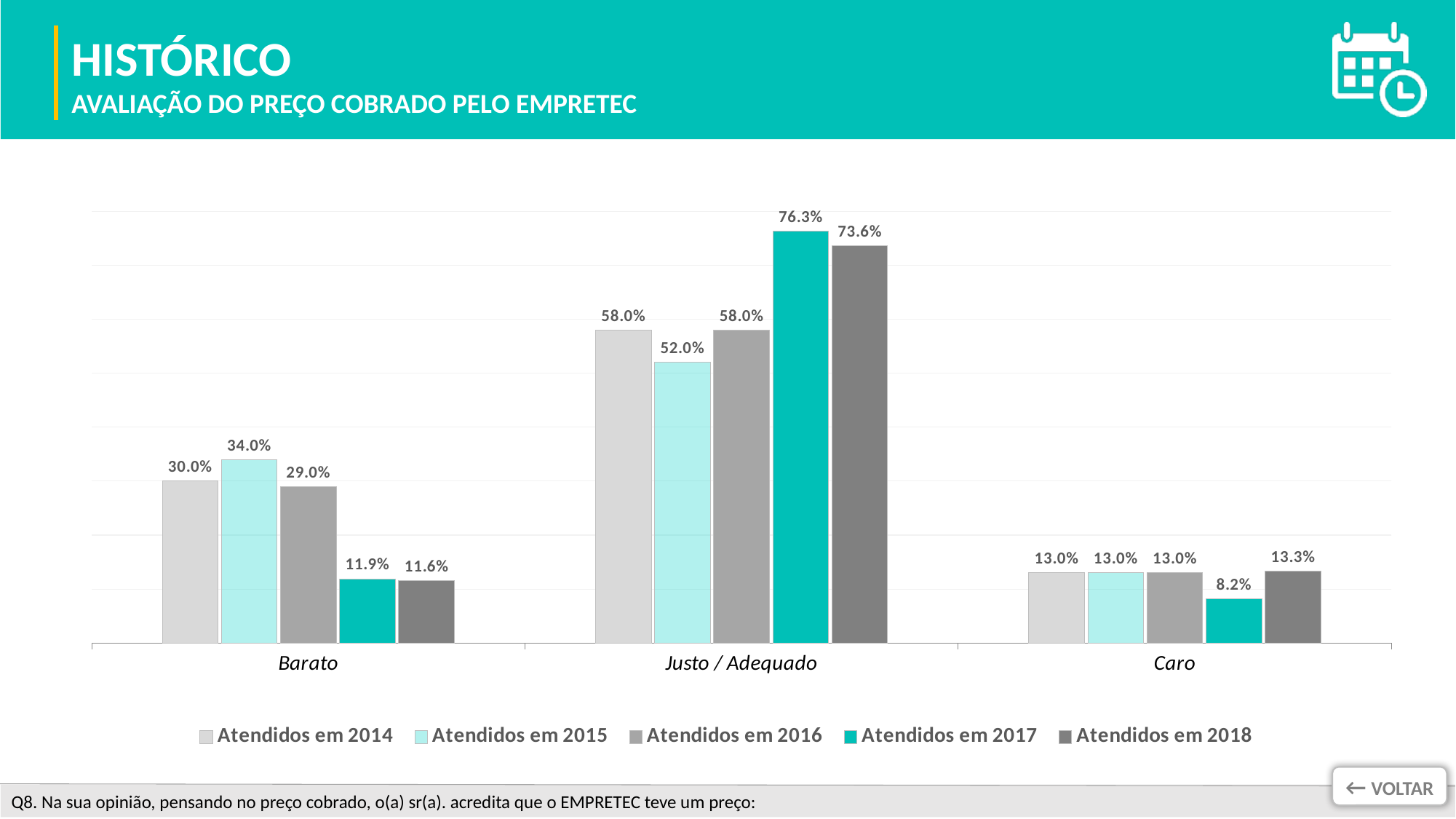
What is the subtitle of the chart shown on the slide? AVALIAÇÃO DO PREÇO COBRADO PELO EMPRETEC Which series has the highest value in the Justo / Adequado category? Atendidos em 2017 What kind of chart is shown on the slide? Bar chart What is the value for Atendidos em 2017 in the Justo / Adequado category? 76.3% What is the difference between the Atendidos em 2015 and Atendidos em 2018 values in the Barato category? 22.4% What is the value for Atendidos em 2015 in the Barato category? 34.0% Which series has the lowest value in the Caro category? Atendidos em 2017 Which is larger in the Barato category: Atendidos em 2014 or Atendidos em 2016? Atendidos em 2014 What is the difference between the Atendidos em 2017 and Atendidos em 2018 values in the Justo / Adequado category? 2.7% What is the value for Atendidos em 2018 in the Caro category? 13.3% How many categories are shown on the x axis? 3 How many series does the legend list? 5